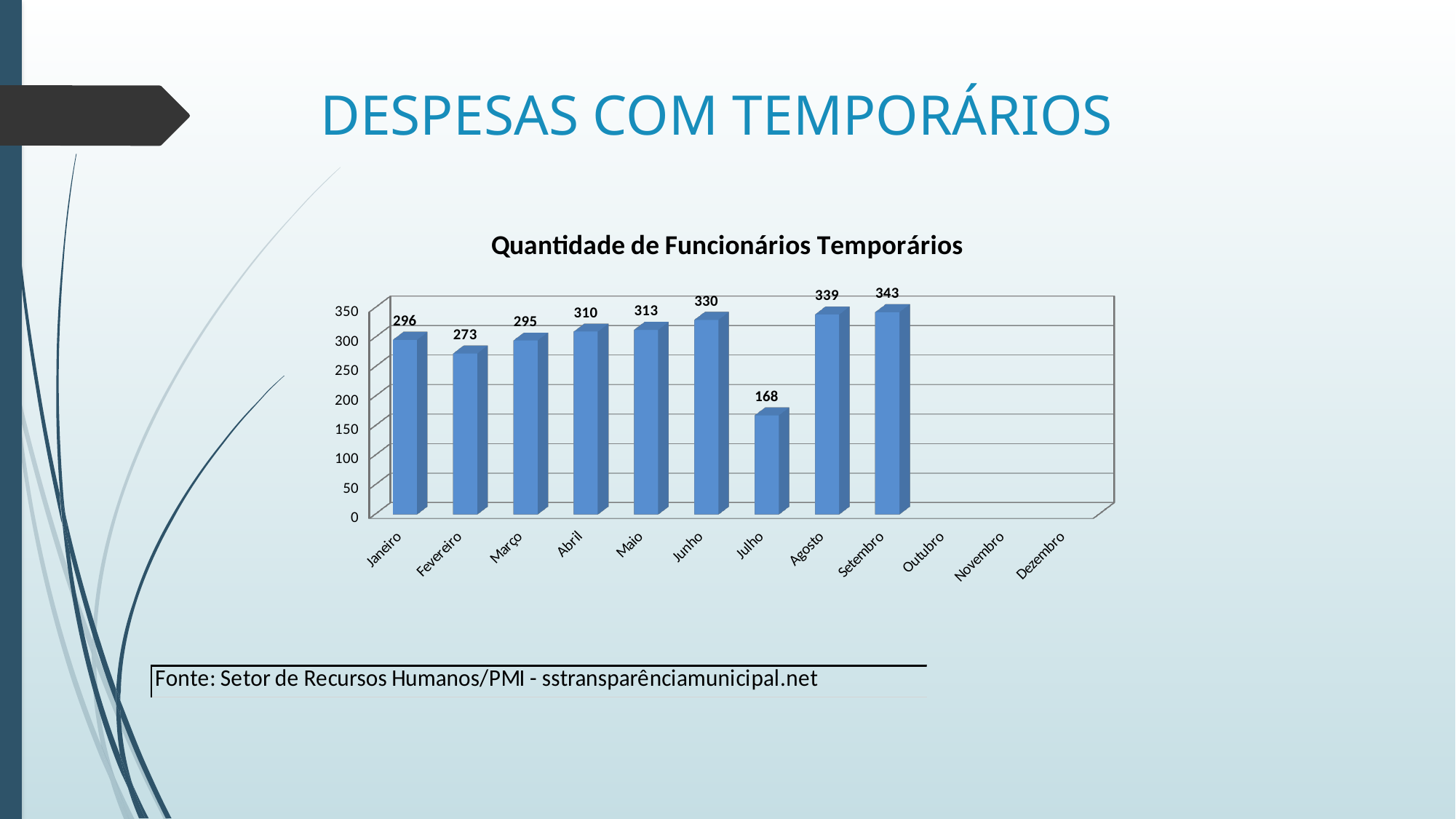
What is the value for Janeiro? 296 Which month has the lowest value among those with bars? Julho How many months have a bar plotted? 9 What is the value for Julho? 168 What is the value for Setembro? 343 Which is larger, the value for Fevereiro or the value for Março? Março What kind of chart is shown? bar chart What is the difference between the values for Setembro and Julho? 175 Which month has the highest value? Setembro Is the value for Junho greater or less than 300? greater What is the title of the chart? Quantidade de Funcionários Temporários How many category labels are shown on the x axis? 12